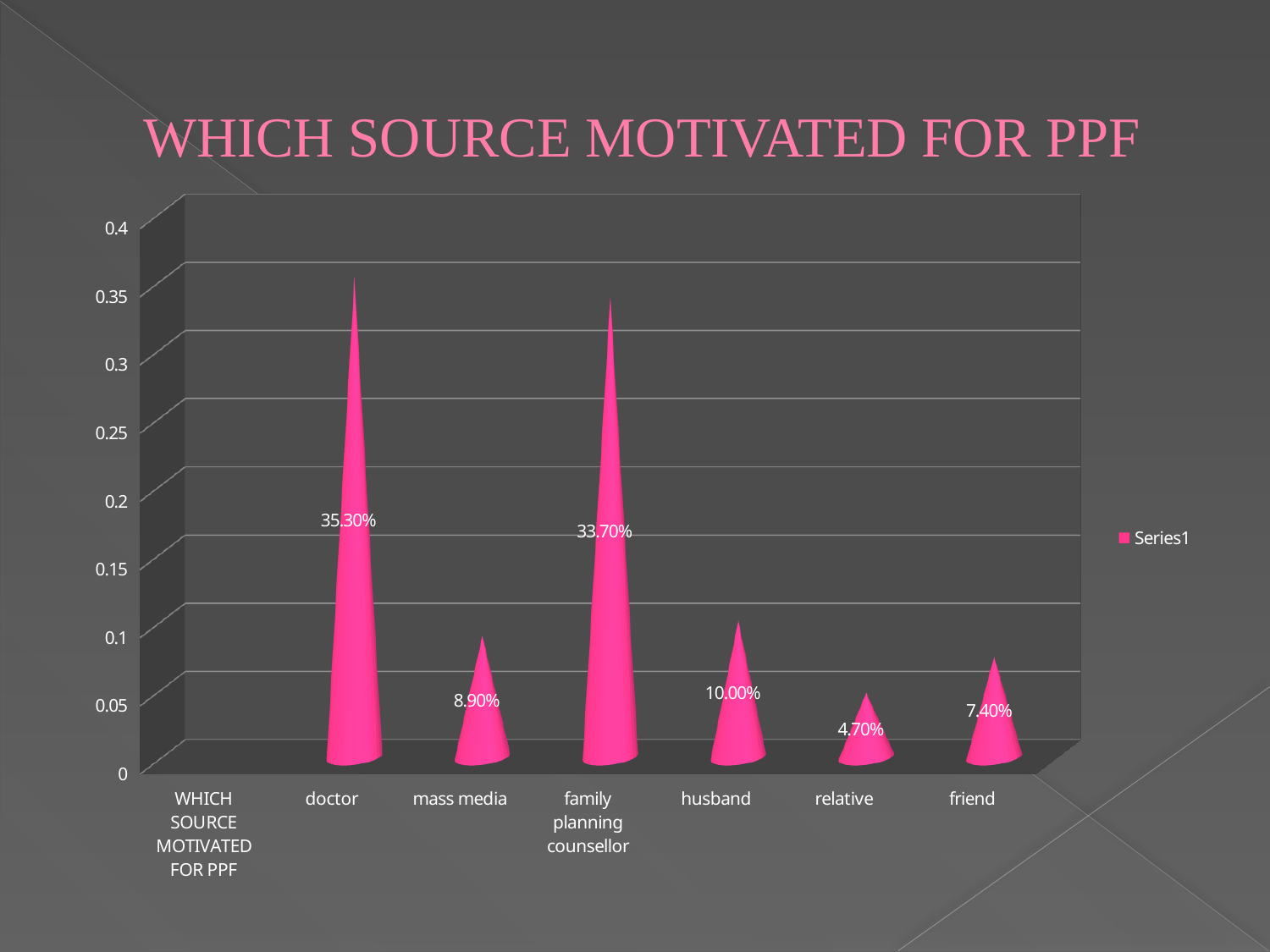
Which is larger, the value for mass media or the value for friend? mass media What is the value for doctor? 35.30% What is the difference between the values for doctor and family planning counsellor? 1.60% What is the value for relative? 4.70% What is the value for family planning counsellor? 33.70% How many bars are plotted on the chart? 6 Is the value for doctor greater or less than 0.3? greater Which source has the highest value? doctor Which source has the lowest value? relative What is the value for husband? 10.00% What kind of chart is shown on the slide? bar chart How many series does the legend list? 1